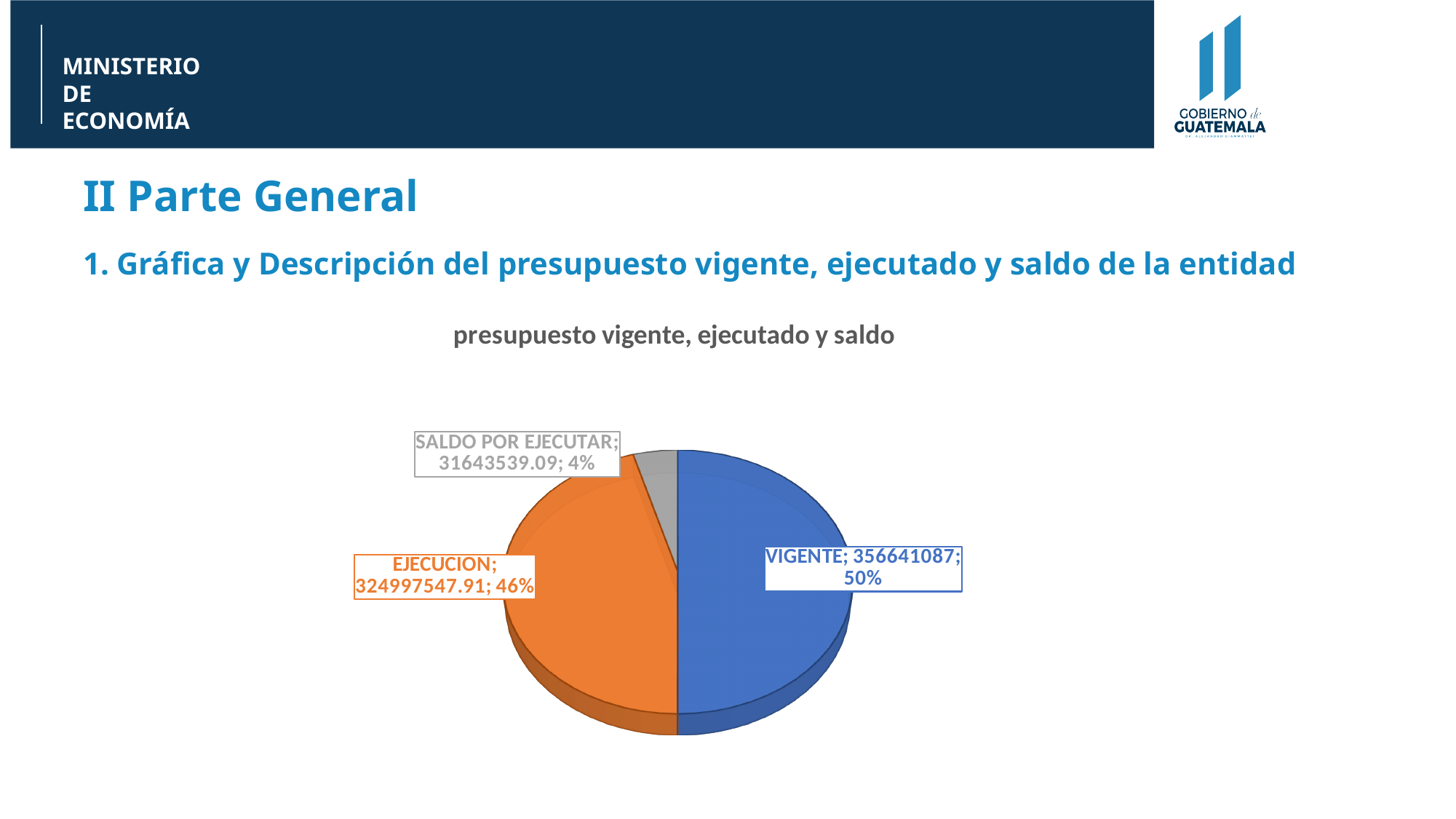
How many slices does the pie chart have? 3 What share of the pie does VIGENTE represent? 50% Which colour is the EJECUCION slice? Orange What is the value for SALDO POR EJECUTAR? 31643539.09 Which slice is the smallest? SALDO POR EJECUTAR Which slice is the largest? VIGENTE What is the value for EJECUCION? 324997547.91 What is the title of the chart? presupuesto vigente, ejecutado y saldo What is the value for VIGENTE? 356641087 What share of the pie does SALDO POR EJECUTAR represent? 4% What share of the pie does EJECUCION represent? 46% What kind of chart is shown on the slide? Pie chart